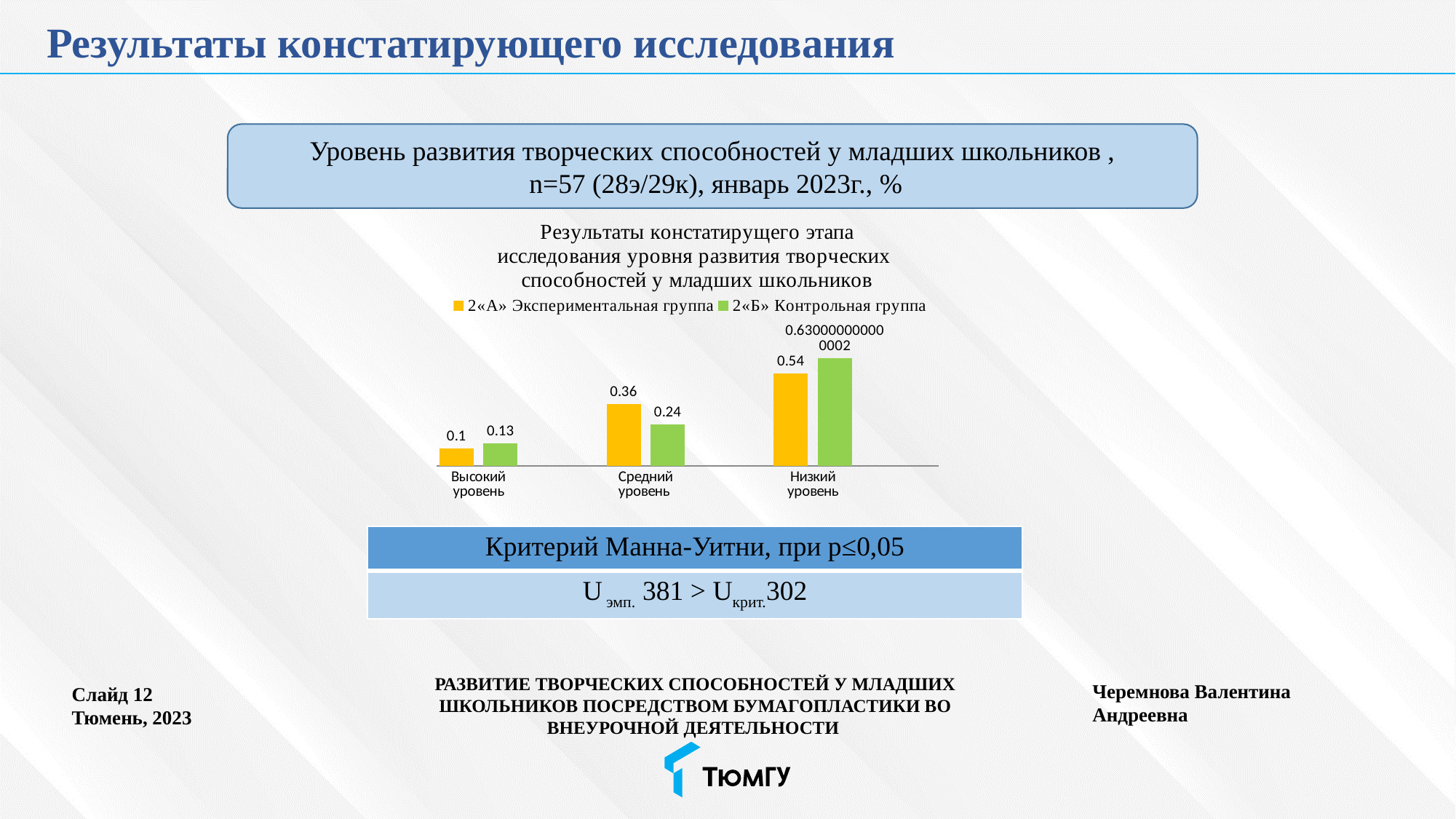
What is the value for the 2«Б» Контрольная группа series at Высокий уровень? 0.13 Which category has the highest value for the 2«А» Экспериментальная группа series? Низкий уровень What kind of chart is shown on the slide? Bar chart How many categories are shown on the x axis of the chart? 3 What is the difference between the 2«А» Экспериментальная группа and 2«Б» Контрольная группа values at Средний уровень? 0.12 Which colour represents the 2«Б» Контрольная группа series in the chart? Green What is the value for the 2«Б» Контрольная группа series at Средний уровень? 0.24 Which category has the lowest value for the 2«Б» Контрольная группа series? Высокий уровень What is the value for the 2«А» Экспериментальная группа series at Высокий уровень? 0.1 How many series does the chart legend list? 2 What is the value for the 2«А» Экспериментальная группа series at Низкий уровень? 0.54 At Средний уровень, which series has the larger value: 2«А» Экспериментальная группа or 2«Б» Контрольная группа? 2«А» Экспериментальная группа